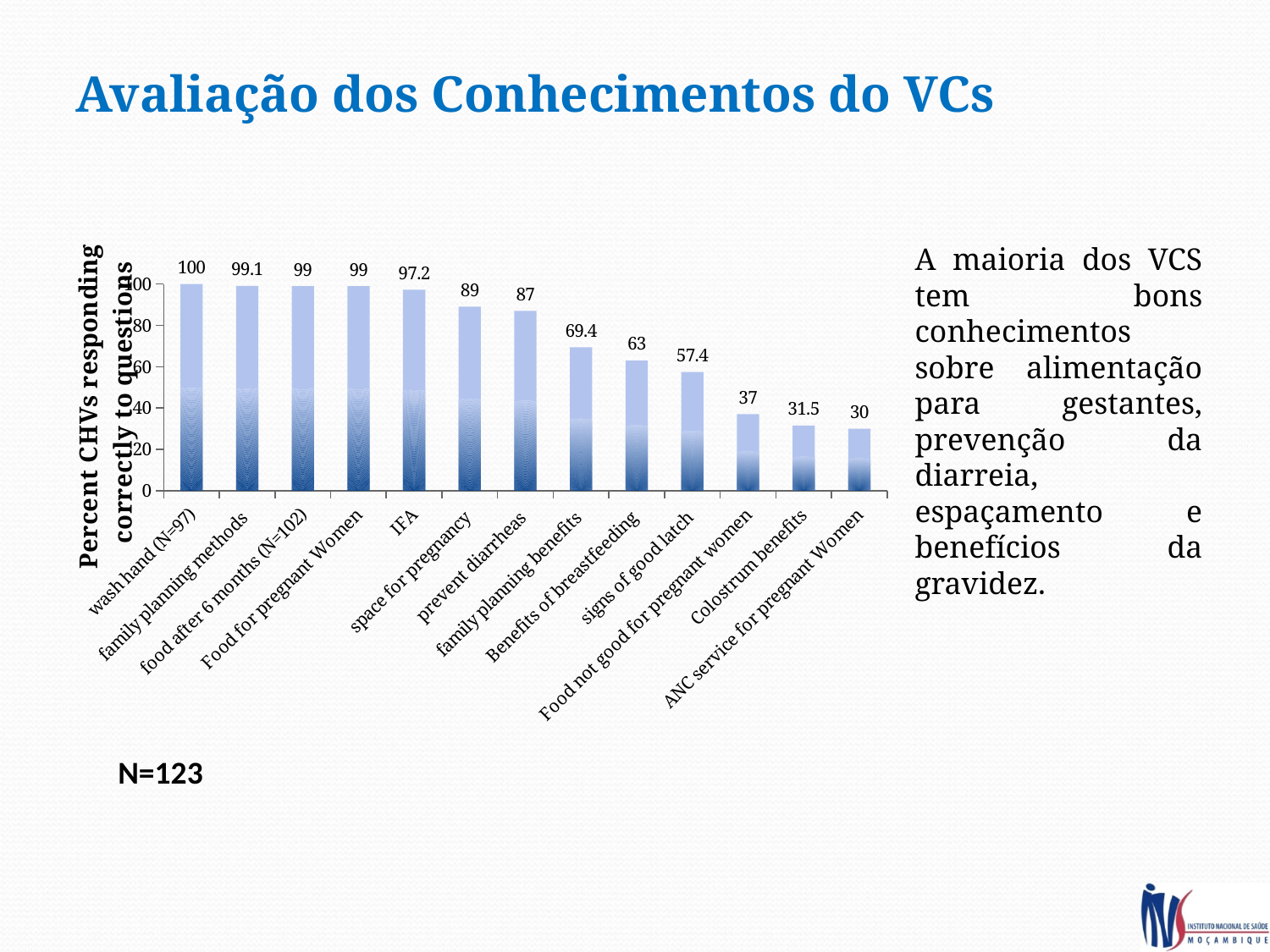
What is the value for family planning benefits? 69.4 What is the value for Colostrum benefits? 31.5 What kind of chart is shown on the slide? bar chart Which category has the lowest value? ANC service for pregnant Women What is the value for signs of good latch? 57.4 What is the label of the vertical axis? Percent CHVs responding correctly to questions How many categories are shown on the x axis? 13 Which is larger, the value for family planning benefits or the value for Benefits of breastfeeding? family planning benefits What is the difference between the values for Benefits of breastfeeding and Food not good for pregnant women? 26 What is the difference between the values for space for pregnancy and prevent diarrheas? 2 What is the value for IFA? 97.2 Which category has the highest value? wash hand (N=97)